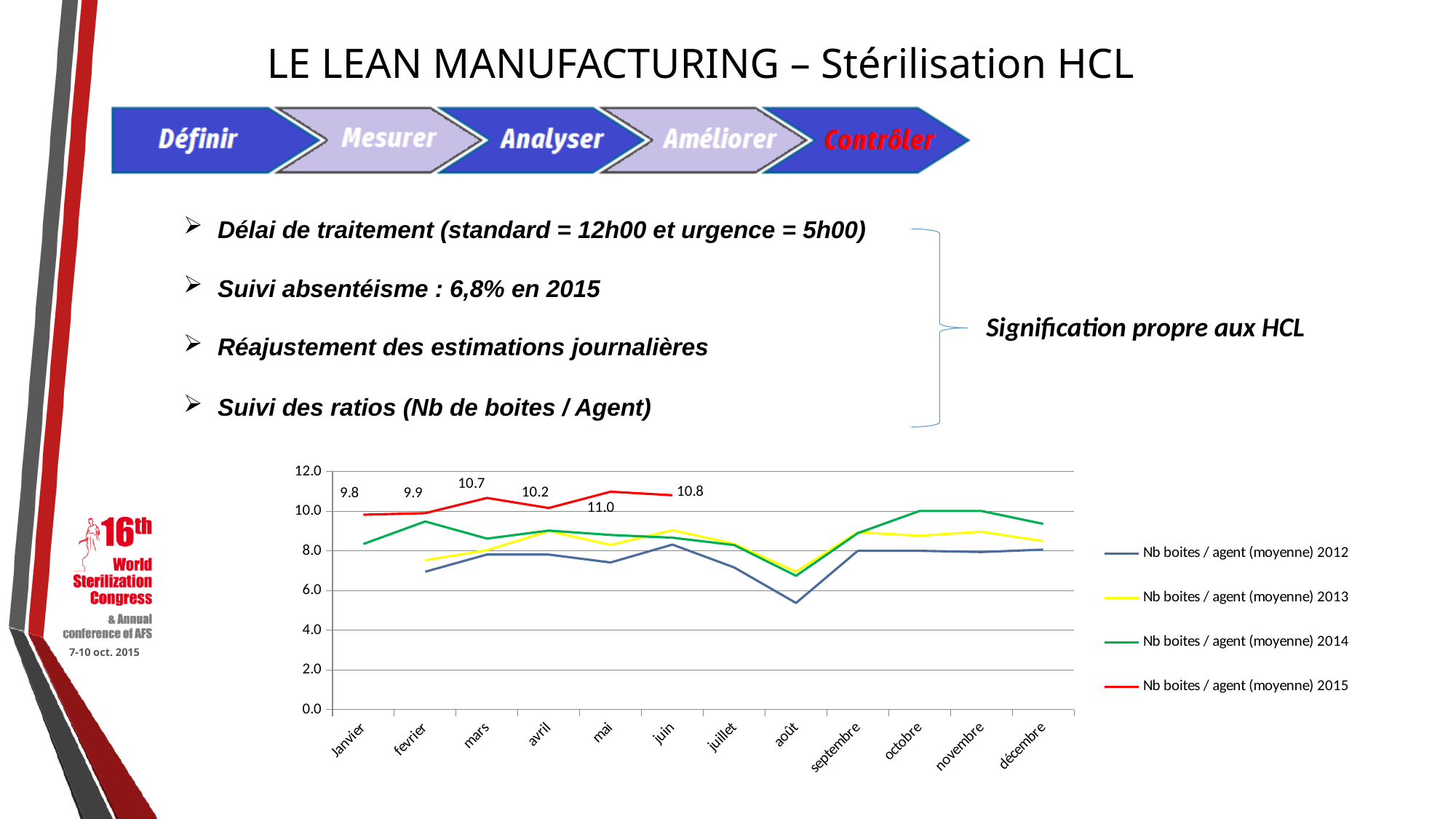
Is the value for août in the 2012 series greater or less than 6.0? less How many series does the chart legend list? 4 What is the value for mars in the series 'Nb boites / agent (moyenne) 2015'? 10.7 What colour is the line for 'Nb boites / agent (moyenne) 2015'? red What is the value for mai in the series 'Nb boites / agent (moyenne) 2015'? 11.0 What is the difference between the 2015 values for mai and janvier? 1.2 How many months are shown on the x axis of the chart? 12 What kind of chart is shown on the slide? line chart In which month does the 2015 series reach its highest labelled value? mai What is the value for janvier in the series 'Nb boites / agent (moyenne) 2015'? 9.8 In which month does the 2015 series have its lowest labelled value? janvier Which is larger in the 2015 series, the value for mars or the value for avril? mars